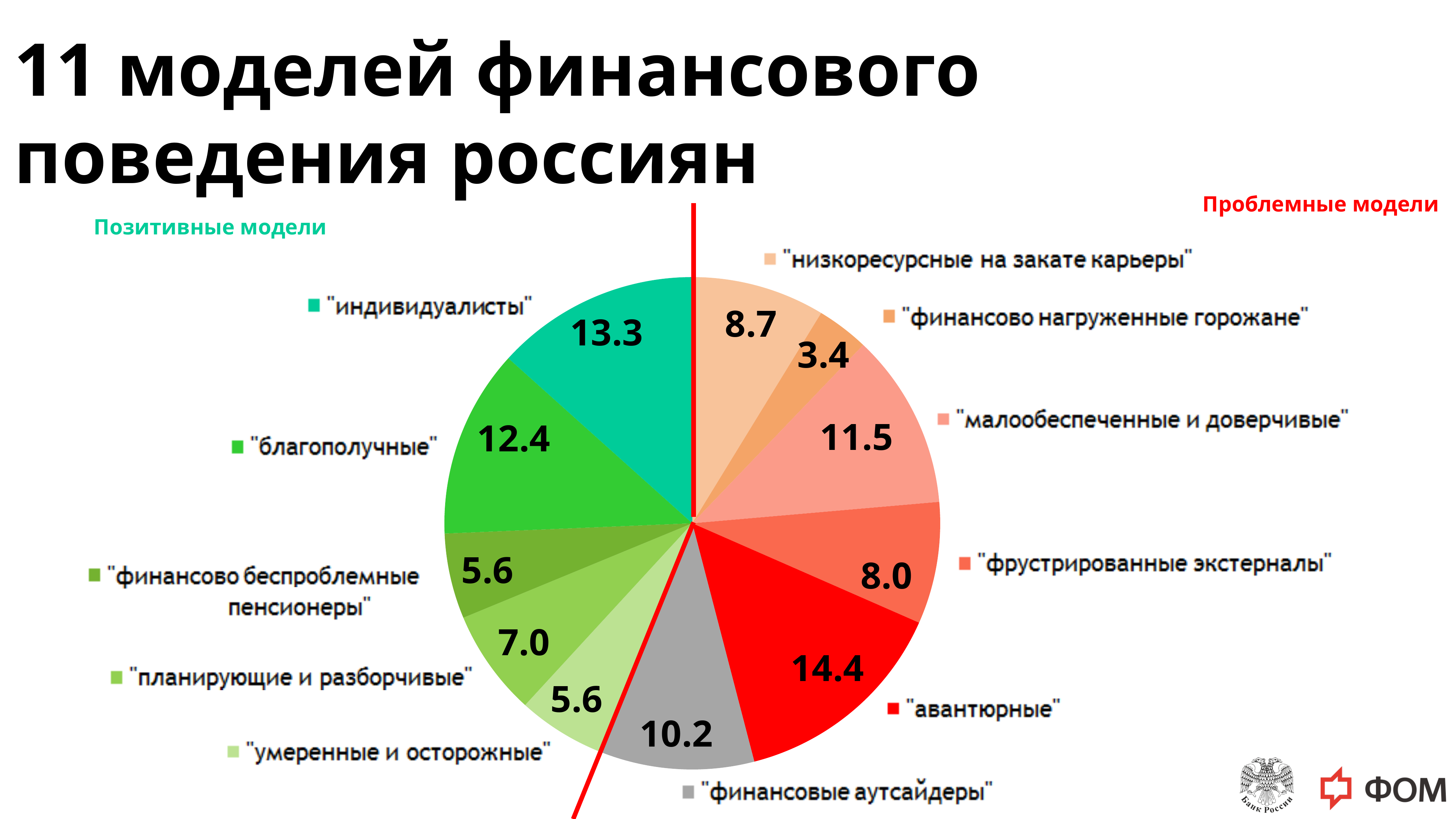
Which category has the largest slice? "авантюрные" Which category has the smallest slice? "финансово нагруженные горожане" What is the value for "финансовые аутсайдеры"? 10.2 What is the value for "авантюрные"? 14.4 What is the value for "индивидуалисты"? 13.3 What is the heading shown in red at the top right of the chart? Проблемные модели What is the difference between the values for "авантюрные" and "индивидуалисты"? 1.1 Which is larger, the value for "благополучные" or the value for "малообеспеченные и доверчивые"? "благополучные" What is the value for "малообеспеченные и доверчивые"? 11.5 What is the value for "планирующие и разборчивые"? 7.0 How many slices does the pie chart have? 11 What kind of chart is shown on the slide? pie chart